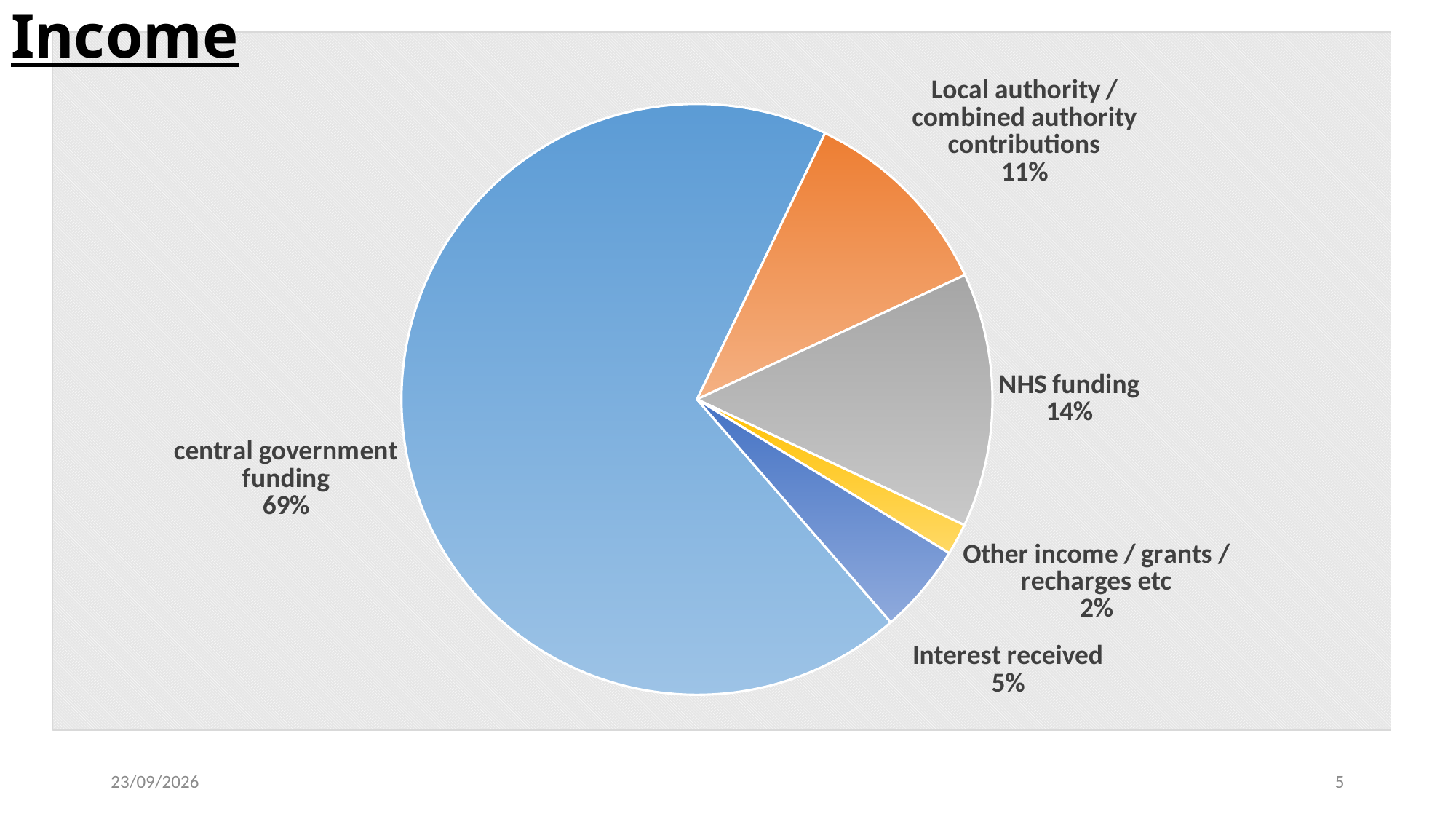
What is the title of the slide containing the pie chart? Income Which income source has the smallest share of the pie? Other income / grants / recharges etc What share of income comes from central government funding? 69% What percentage is shown for Local authority / combined authority contributions? 11% Which income source has the largest share of the pie? central government funding What percentage is shown for Interest received? 5% What share of income is NHS funding? 14% What is the difference in percentage points between NHS funding and Local authority / combined authority contributions? 3% How many slices does the pie chart have? 5 Which is larger, the share for Interest received or the share for Other income / grants / recharges etc? Interest received What kind of chart is shown on the slide? pie chart What percentage is shown for Other income / grants / recharges etc? 2%